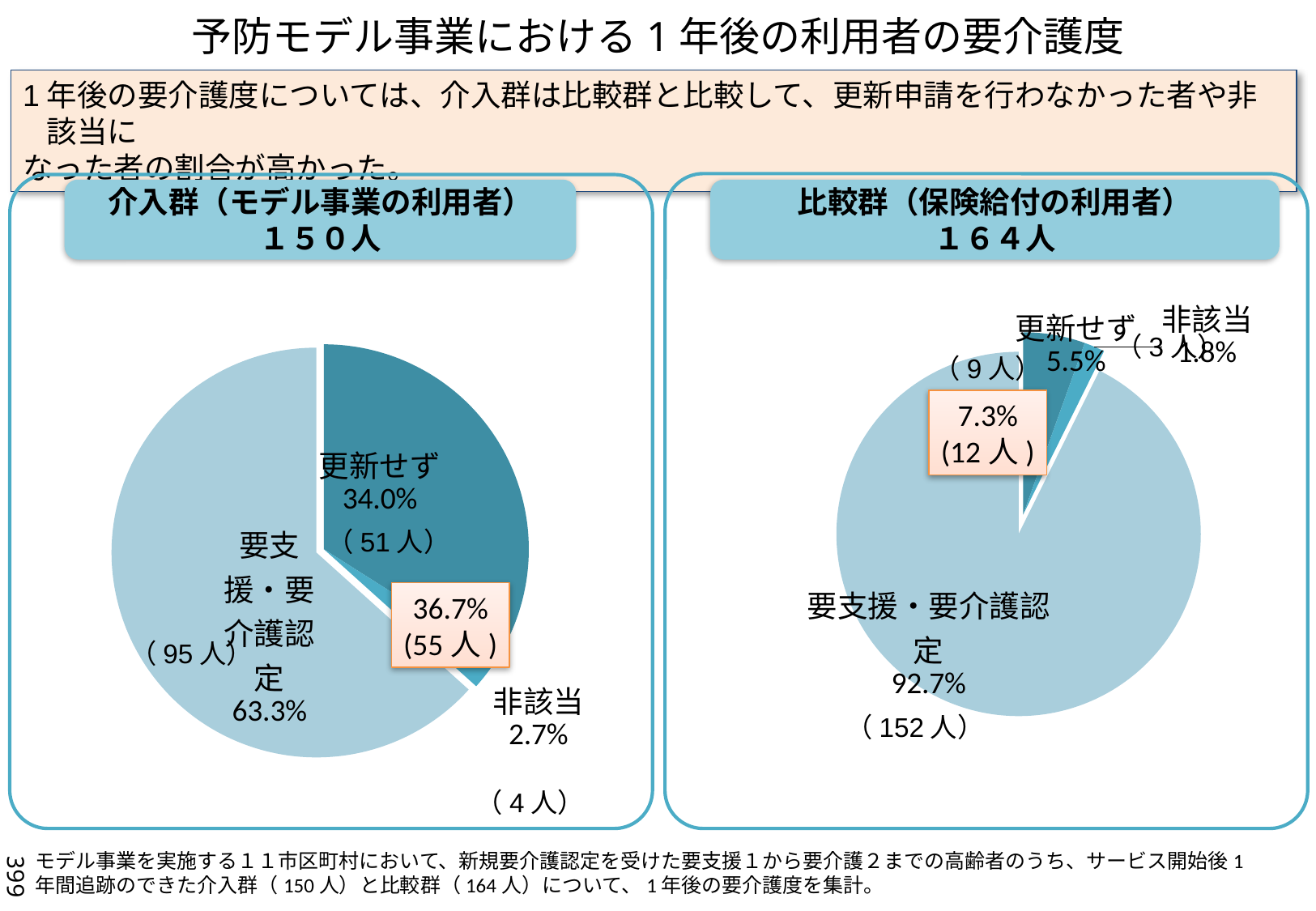
左の円グラフ（介入群）で、最も割合が大きい区分はどれですか？ 要支援・要介護認定 右の円グラフ（比較群）の対象人数は何人ですか？ 164人 左の円グラフ（介入群）で、「更新せず」の割合は何％ですか？ 34.0% 左の円グラフ（介入群）で、「要支援・要介護認定」の人数は何人ですか？ 95人 右の円グラフ（比較群）で、「非該当」の人数は何人ですか？ 3人 「更新せず」の割合は、介入群と比較群のどちらが大きいですか？ 介入群 このスライドのグラフはどの種類のグラフですか？ 円グラフ 右の円グラフ（比較群）で、「更新せず」の人数は何人ですか？ 9人 右の円グラフ（比較群）で、最も割合が小さい区分はどれですか？ 非該当 左の円グラフ（介入群）で、「非該当」の割合は何％ですか？ 2.7% 左の円グラフ（介入群）で、「更新せず」と「非該当」の割合の差は何ポイントですか？ 31.3ポイント 右の円グラフ（比較群）で、「要支援・要介護認定」の割合は何％ですか？ 92.7%